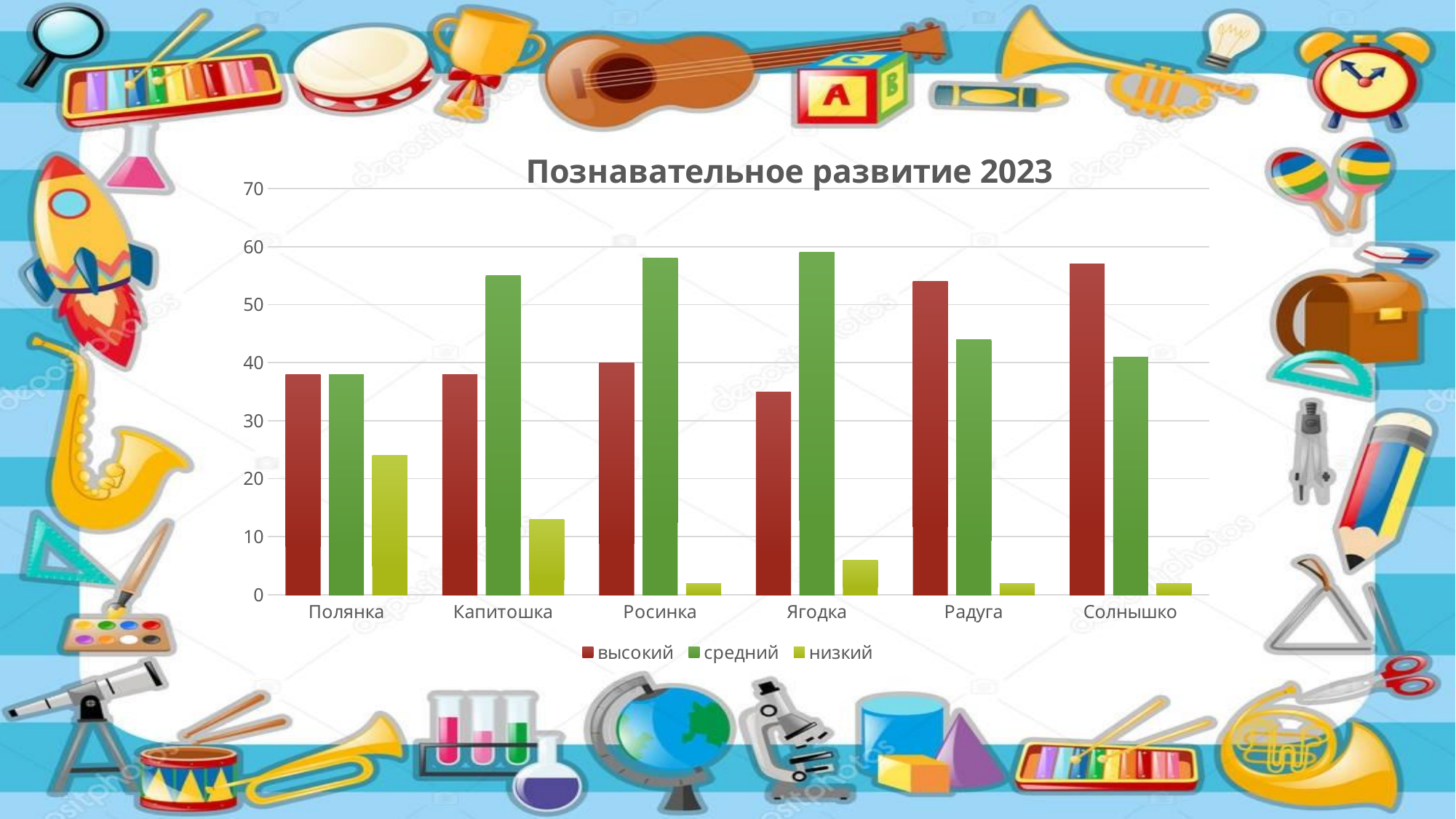
How many series does the legend list? 3 For Капитошка, which is larger: the высокий value or the средний value? средний What is the title of the chart? Познавательное развитие 2023 How many categories (kindergarten groups) are shown on the x axis? 6 Which category has the highest value for the низкий series? Полянка Which series is shown in red in the legend? высокий What kind of chart is shown on the slide? bar chart Is the низкий value for Полянка greater or less than 20? greater Is the низкий value for Росинка greater or less than 10? less Is the высокий value for Ягодка greater or less than 40? less For Радуга, which is larger: the высокий value or the средний value? высокий